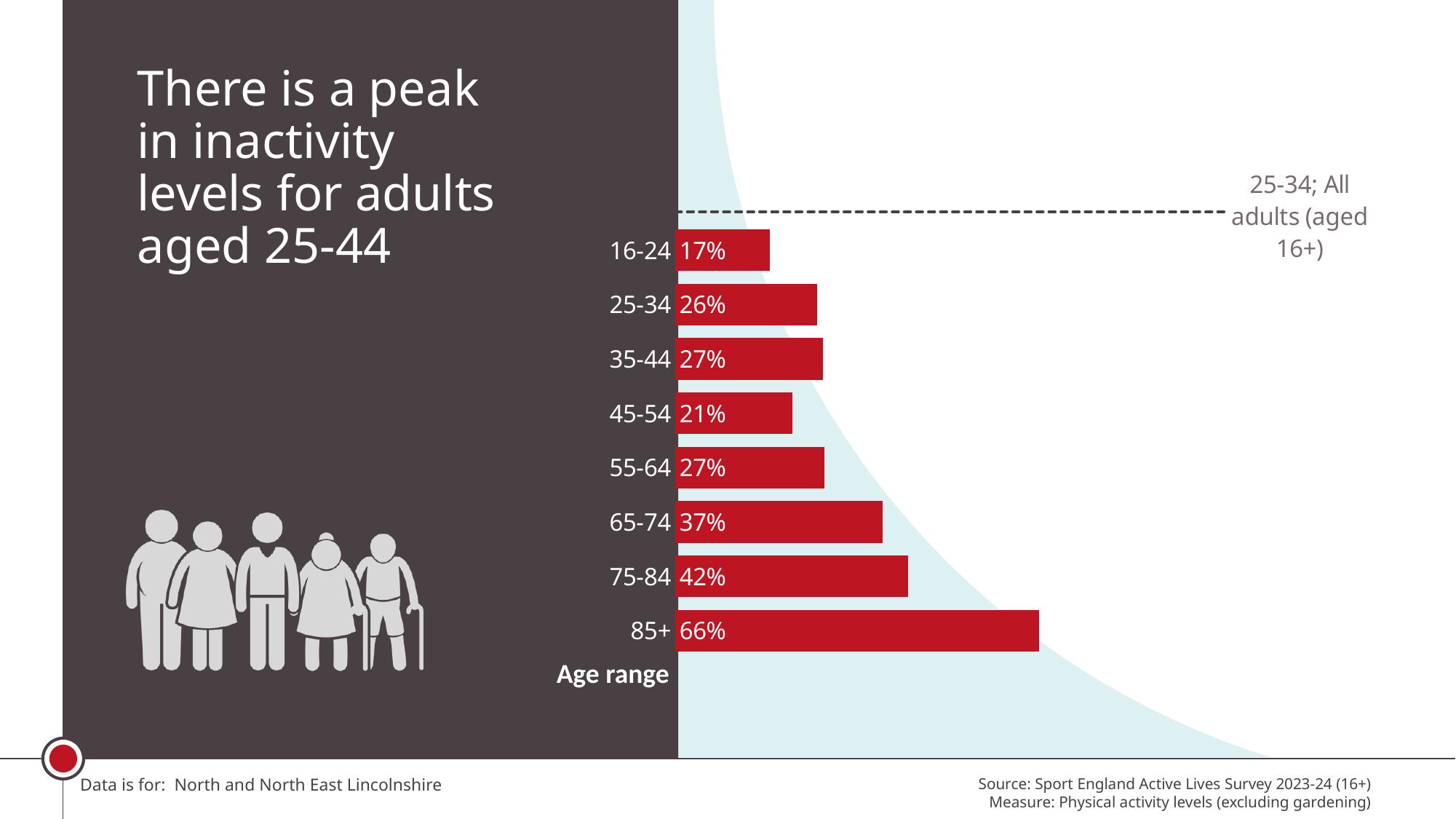
What is the inactivity level for the 45-54 age range? 21% What is the difference between the inactivity levels for 25-34 and 16-24? 9% Which age range has the lowest inactivity level? 16-24 Which has a higher inactivity level, 25-34 or 45-54? 25-34 What is the inactivity level for the 16-24 age range? 17% Which has a higher inactivity level, 65-74 or 55-64? 65-74 What is the difference between the inactivity levels for 85+ and 75-84? 24% What kind of chart is shown on the slide? Bar chart What is the inactivity level for the 85+ age range? 66% What is the label below the category axis of the chart? Age range Which age range has the highest inactivity level? 85+ How many age ranges are shown in the chart? 8